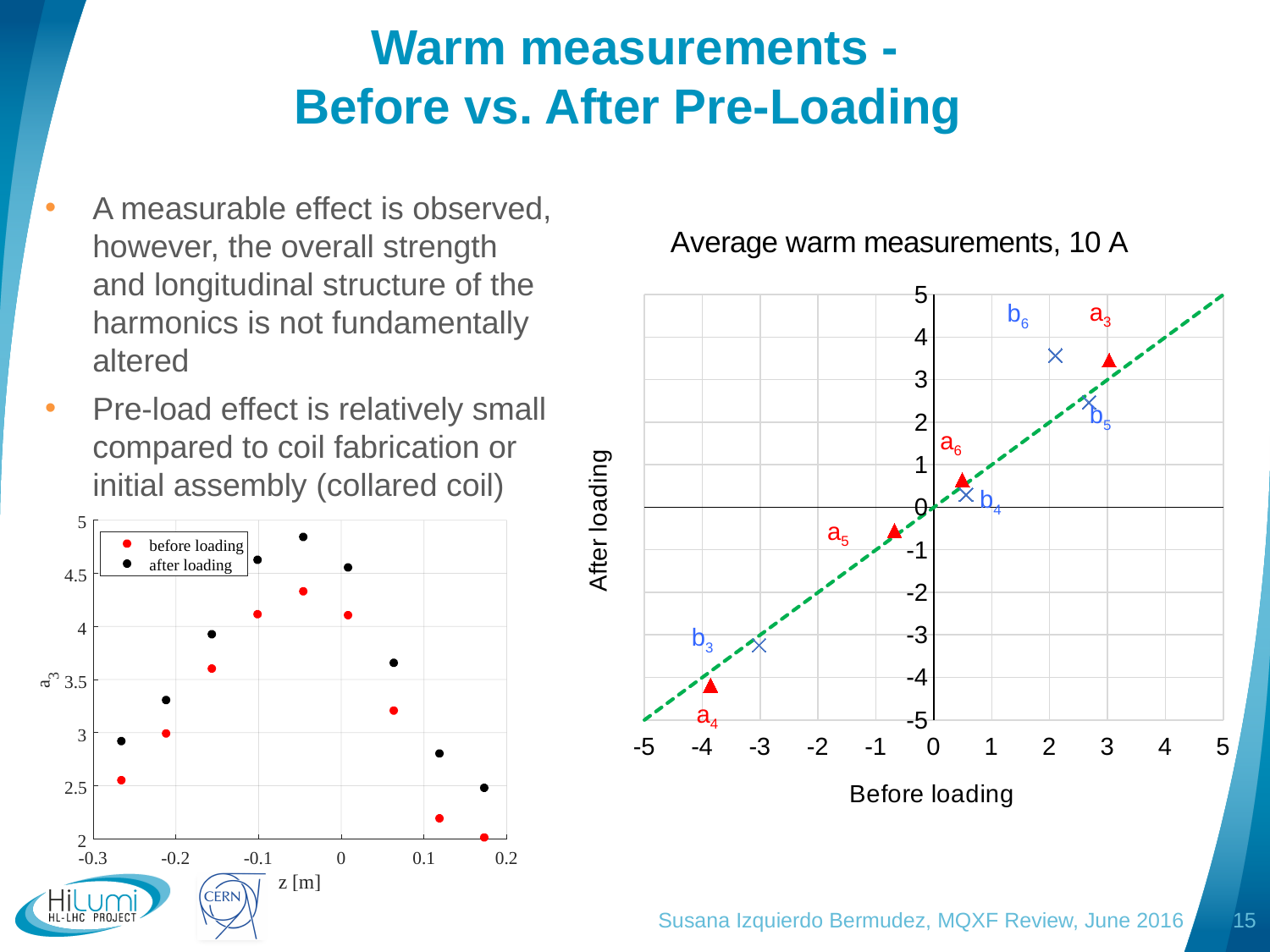
In the left chart, which series has the higher a3 values across the z range, 'before loading' or 'after loading'? after loading In the chart titled 'Average warm measurements, 10 A', what is the label of the horizontal axis? Before loading In the chart titled 'Average warm measurements, 10 A', is the 'After loading' value of a3 greater or less than 3? greater In the chart titled 'Average warm measurements, 10 A', which point has the lowest 'After loading' value? a4 How many series does the legend of the left chart list? 2 In the left chart, is the 'before loading' value at the leftmost point (z ≈ -0.27 m) greater or less than 3? less In the chart titled 'Average warm measurements, 10 A', is the 'Before loading' value of b3 greater or less than -2? less In the chart titled 'Average warm measurements, 10 A', how many labelled data points are plotted? 8 In the left chart, how many points are plotted for the 'before loading' series? 9 What kind of chart is the left chart showing a3 against z [m]? scatter chart In the left chart, how do the a3 values change as z increases from -0.3 to 0.2 m? rise then fall